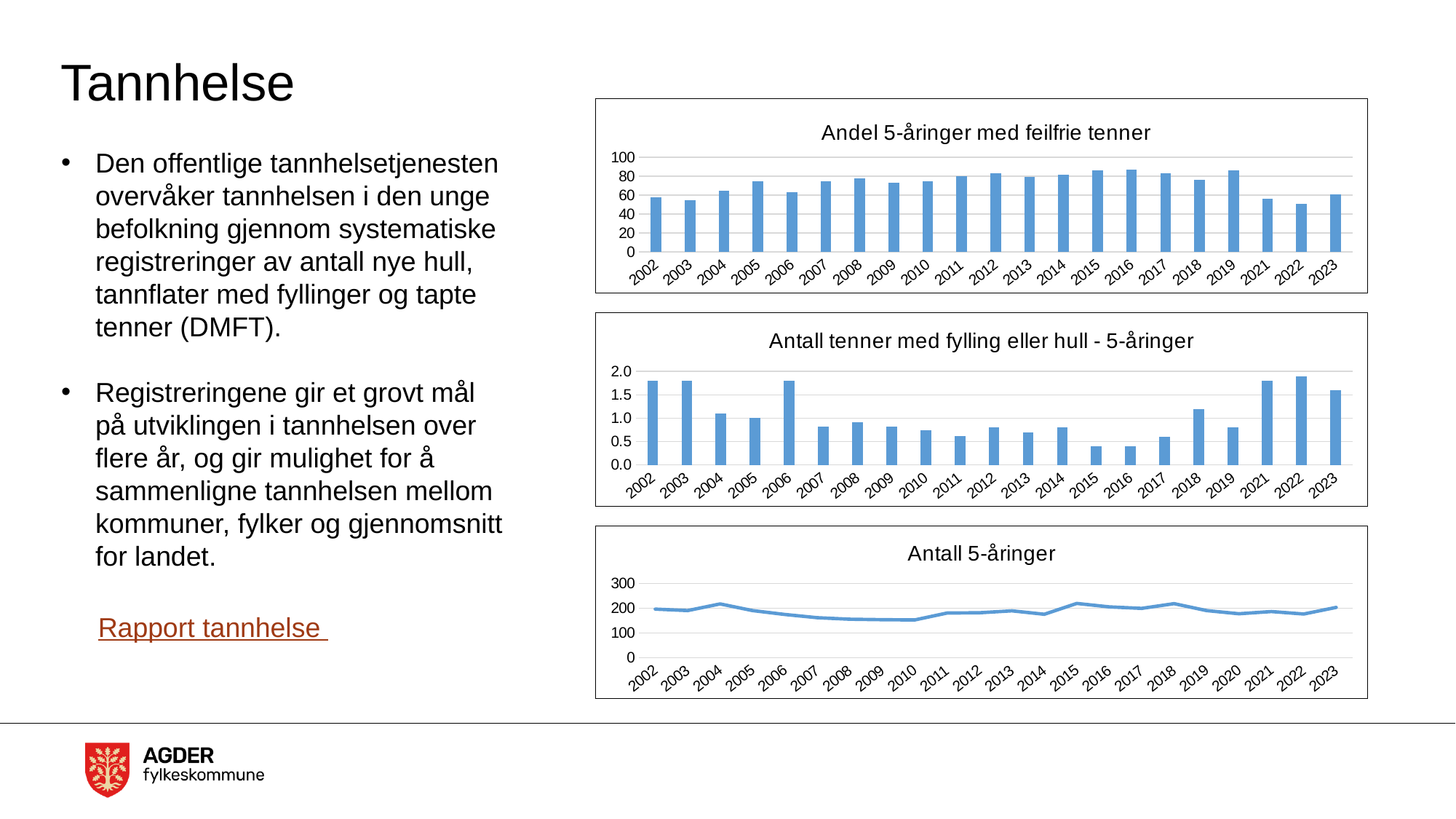
What kind of chart is the top chart, 'Andel 5-åringer med feilfrie tenner'? bar chart In the top chart 'Andel 5-åringer med feilfrie tenner', is the value for 2022 greater or less than 60? less How many years are shown on the x axis of the top chart 'Andel 5-åringer med feilfrie tenner'? 21 In the middle chart 'Antall tenner med fylling eller hull - 5-åringer', which is larger, the value for 2018 or the value for 2019? 2018 In the top chart 'Andel 5-åringer med feilfrie tenner', is the value for 2015 greater or less than 80? greater In the middle chart 'Antall tenner med fylling eller hull - 5-åringer', is the value for 2015 greater or less than 0.5? less How many years are shown on the x axis of the bottom chart 'Antall 5-åringer'? 22 In the top chart 'Andel 5-åringer med feilfrie tenner', which year has the lowest value? 2022 In the top chart 'Andel 5-åringer med feilfrie tenner', which is larger, the value for 2016 or the value for 2022? 2016 In the middle chart 'Antall tenner med fylling eller hull - 5-åringer', which year has the highest value? 2022 What kind of chart is the bottom chart, 'Antall 5-åringer'? line chart